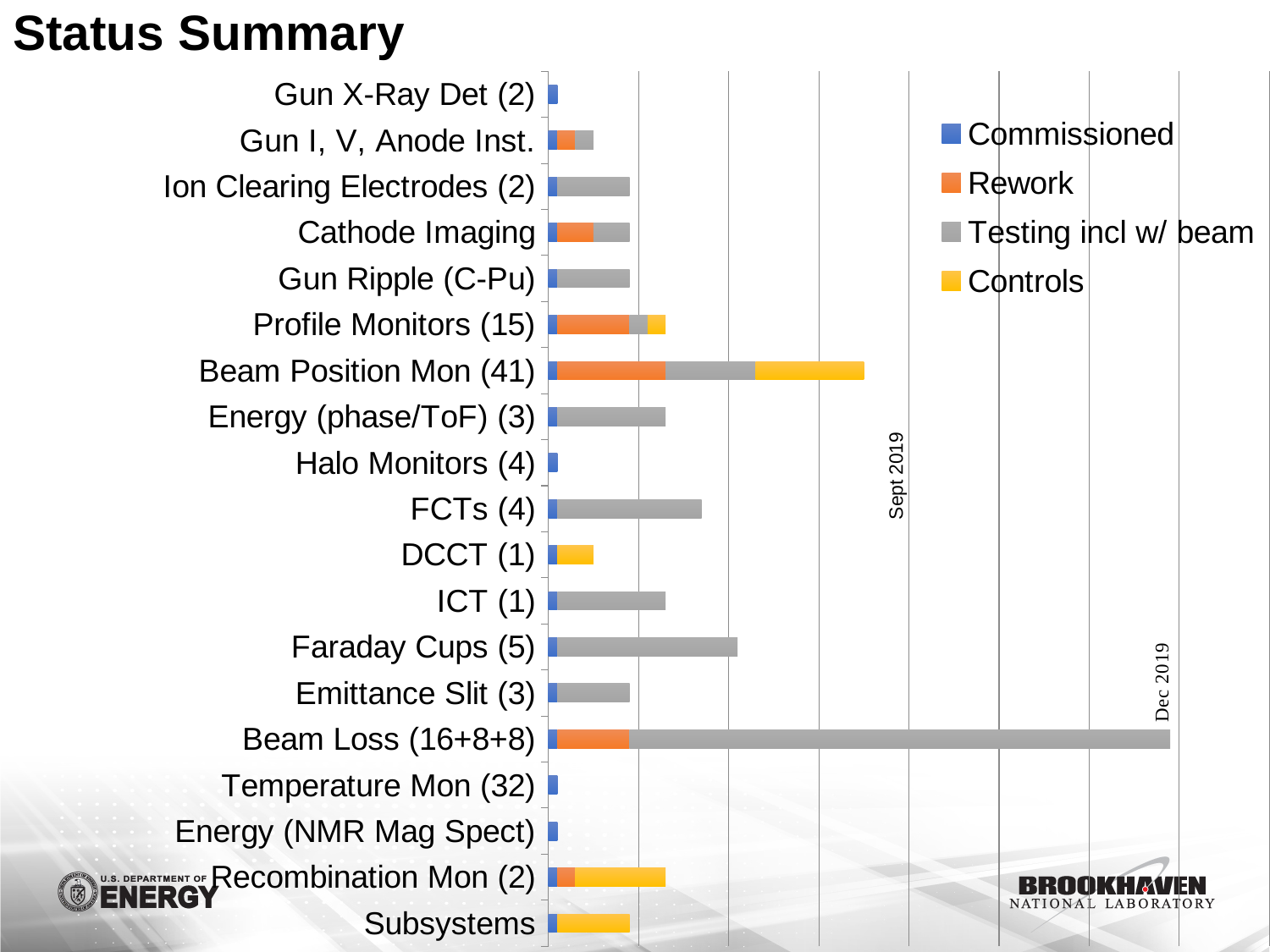
Which bar is longer overall, FCTs (4) or Halo Monitors (4)? FCTs (4) Which bar is longer overall, Beam Position Mon (41) or Profile Monitors (15)? Beam Position Mon (41) What is the title of the slide containing the chart? Status Summary Which category has the longest bar overall? Beam Loss (16+8+8) Which series is shown in orange in the legend? Rework Which category has the longest Rework (orange) segment? Beam Position Mon (41) How many series does the legend list? 4 Which bar is longer overall, Faraday Cups (5) or Emittance Slit (3)? Faraday Cups (5) Which category has the longest Controls (yellow) segment? Beam Position Mon (41) How many categories are plotted on the chart? 19 What kind of chart is shown on the slide? Stacked bar chart